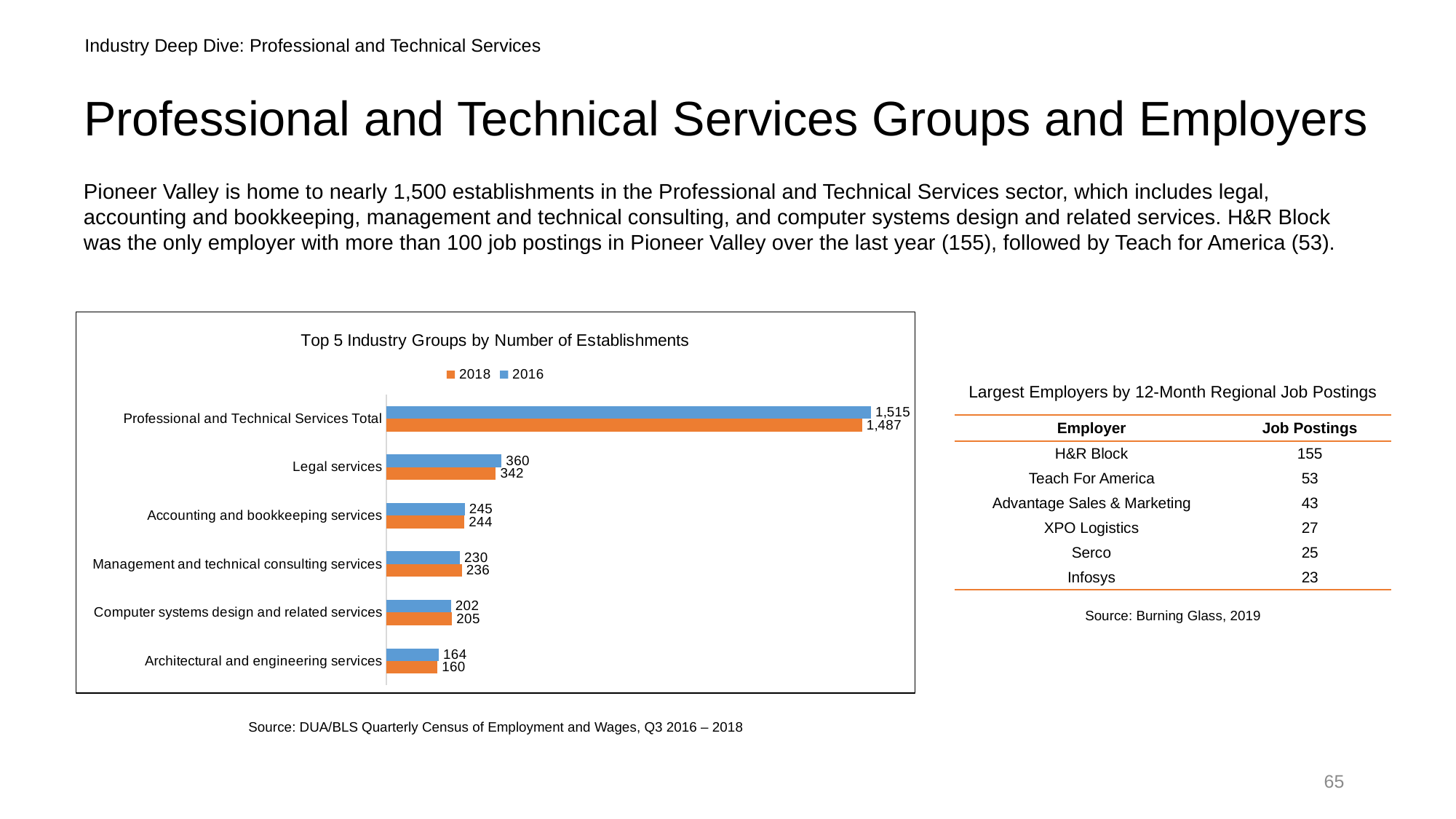
How many series does the legend of the "Top 5 Industry Groups by Number of Establishments" chart list? 2 In the "Top 5 Industry Groups by Number of Establishments" chart, what is the 2018 value for Professional and Technical Services Total? 1,487 In the "Top 5 Industry Groups by Number of Establishments" chart, what is the 2018 value for Management and technical consulting services? 236 In the "Top 5 Industry Groups by Number of Establishments" chart, what is the difference between the 2016 and 2018 values for Professional and Technical Services Total? 28 In the "Top 5 Industry Groups by Number of Establishments" chart, excluding the total, which industry group has the highest 2016 value? Legal services In the "Top 5 Industry Groups by Number of Establishments" chart, what is the 2016 value for Legal services? 360 How many categories are shown on the y axis of the "Top 5 Industry Groups by Number of Establishments" chart? 6 In the "Top 5 Industry Groups by Number of Establishments" chart, is the 2018 value for Computer systems design and related services larger or smaller than its 2016 value? larger In the "Top 5 Industry Groups by Number of Establishments" chart, which category has the lowest 2018 value? Architectural and engineering services What kind of chart is "Top 5 Industry Groups by Number of Establishments"? bar chart In the "Top 5 Industry Groups by Number of Establishments" chart, what is the 2016 value for Architectural and engineering services? 164 In the "Top 5 Industry Groups by Number of Establishments" chart, what is the difference between the 2016 and 2018 values for Legal services? 18